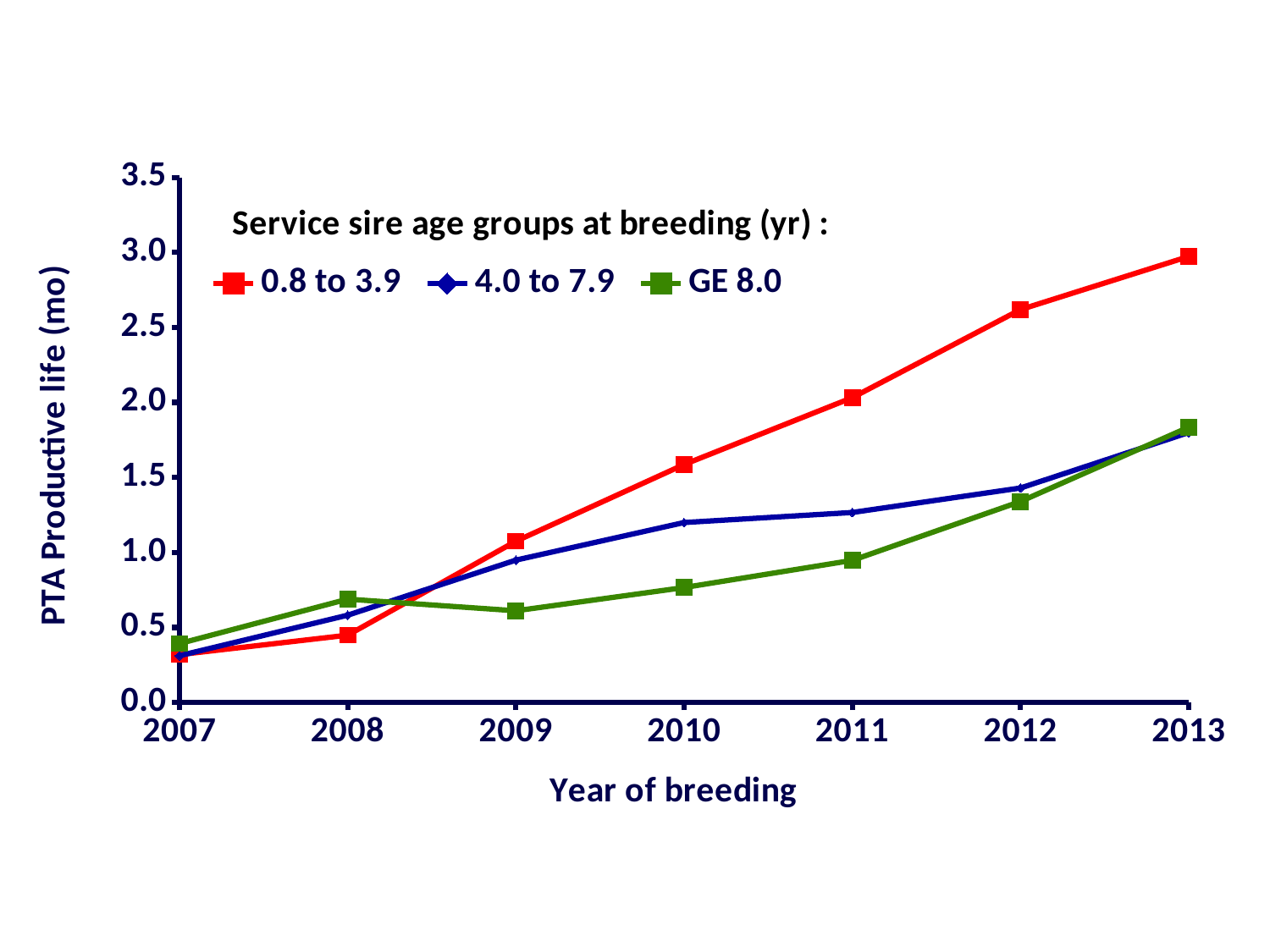
Is the value for the 0.8 to 3.9 series in 2013 greater or less than 2.5? greater What kind of chart is shown on the slide? line chart Is the value for the 4.0 to 7.9 series in 2010 greater or less than 1.0? greater Does the 0.8 to 3.9 series rise or fall from 2007 to 2013? rise Which service sire age group has the lowest PTA Productive life in 2011? GE 8.0 In 2012, which series has the higher value: 0.8 to 3.9 or GE 8.0? 0.8 to 3.9 Is the value for the GE 8.0 series in 2009 greater or less than 1.0? less How many series does the legend list? 3 How many years are plotted along the x axis? 7 In 2008, which series has the higher value: 0.8 to 3.9 or GE 8.0? GE 8.0 Which service sire age group has the highest PTA Productive life in 2013? 0.8 to 3.9 What is the title of the y axis? PTA Productive life (mo)